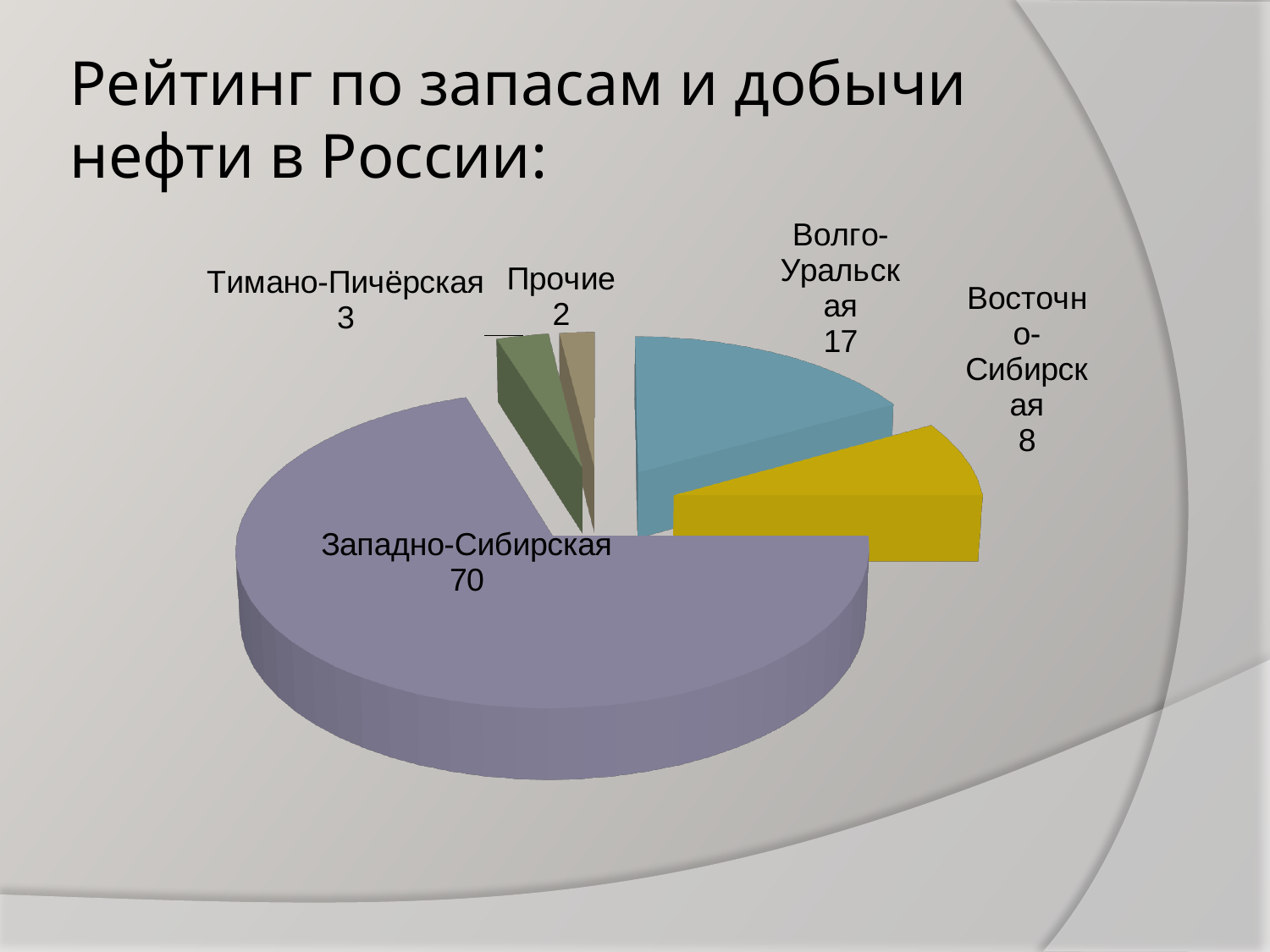
Which is larger, Восточно-Сибирская or Тимано-Пичёрская? Восточно-Сибирская What is the value for Тимано-Пичёрская? 3 What is the value for Прочие? 2 What kind of chart is shown on the slide? pie chart What is the value for Волго-Уральская? 17 How many slices does the pie chart have? 5 What is the value for Западно-Сибирская? 70 What is the difference between the values for Западно-Сибирская and Волго-Уральская? 53 Which category has the largest slice? Западно-Сибирская What share of the pie does Западно-Сибирская represent? 70% Which category has the smallest slice? Прочие What is the value for Восточно-Сибирская? 8